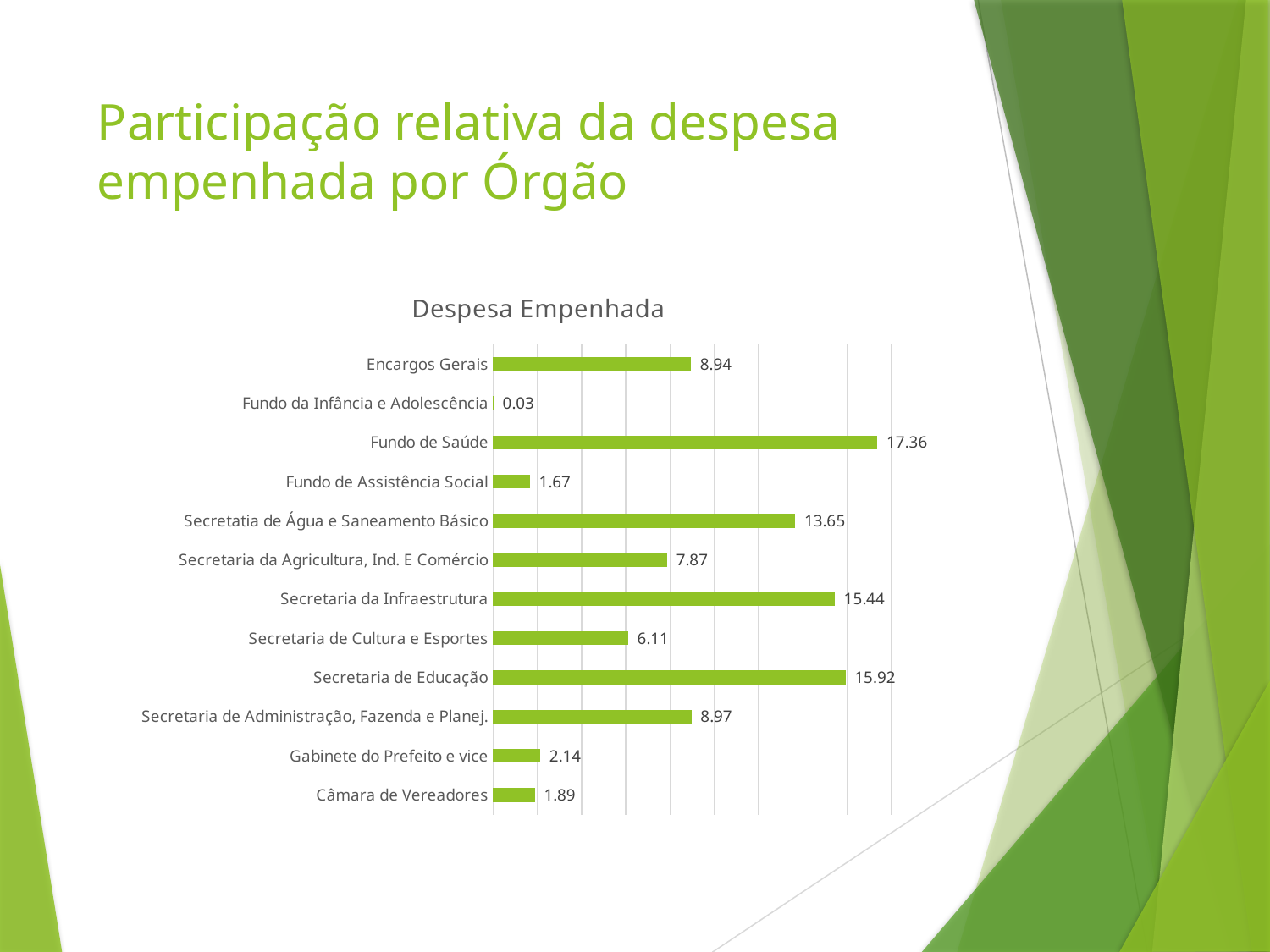
What kind of chart is shown on the slide? Bar chart Which category has the highest value? Fundo de Saúde How many categories are shown in the chart? 12 What is the title of the chart? Despesa Empenhada What is the value for Gabinete do Prefeito e vice? 2.14 Which is larger, the value for Secretaria da Infraestrutura or the value for Secretatia de Água e Saneamento Básico? Secretaria da Infraestrutura Which category has the lowest value? Fundo da Infância e Adolescência What is the difference between the values for Secretaria da Infraestrutura and Secretatia de Água e Saneamento Básico? 1.79 What is the value for Secretaria de Educação? 15.92 What is the value for Fundo de Saúde? 17.36 What is the difference between the values for Fundo de Saúde and Secretaria de Educação? 1.44 What is the value for Secretaria de Cultura e Esportes? 6.11